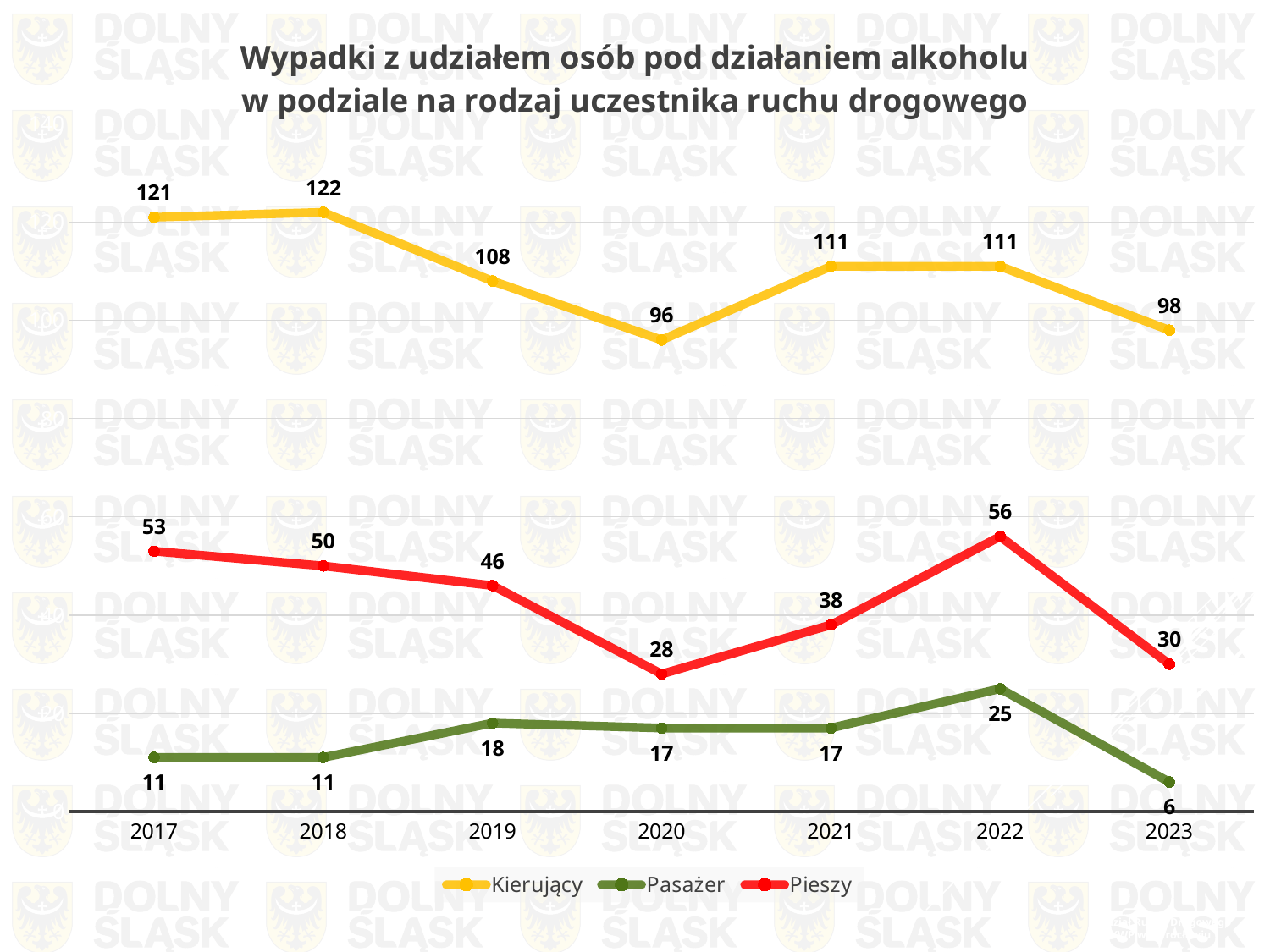
How many series does the legend list? 3 What is the value for Pieszy in 2022? 56 What kind of chart is shown on the slide? Line chart What is the difference between the Pieszy values in 2022 and 2023? 26 Does the value for Pieszy rise or fall from 2017 to 2020? Fall In which year is the value for Pasażer highest? 2022 How many years are shown on the x axis? 7 What is the value for Pasażer in 2023? 6 Which series is drawn in red? Pieszy What is the value for Kierujący in 2018? 122 In which year is the value for Kierujący lowest? 2020 Which is larger in 2019: the value for Pieszy or the value for Pasażer? Pieszy